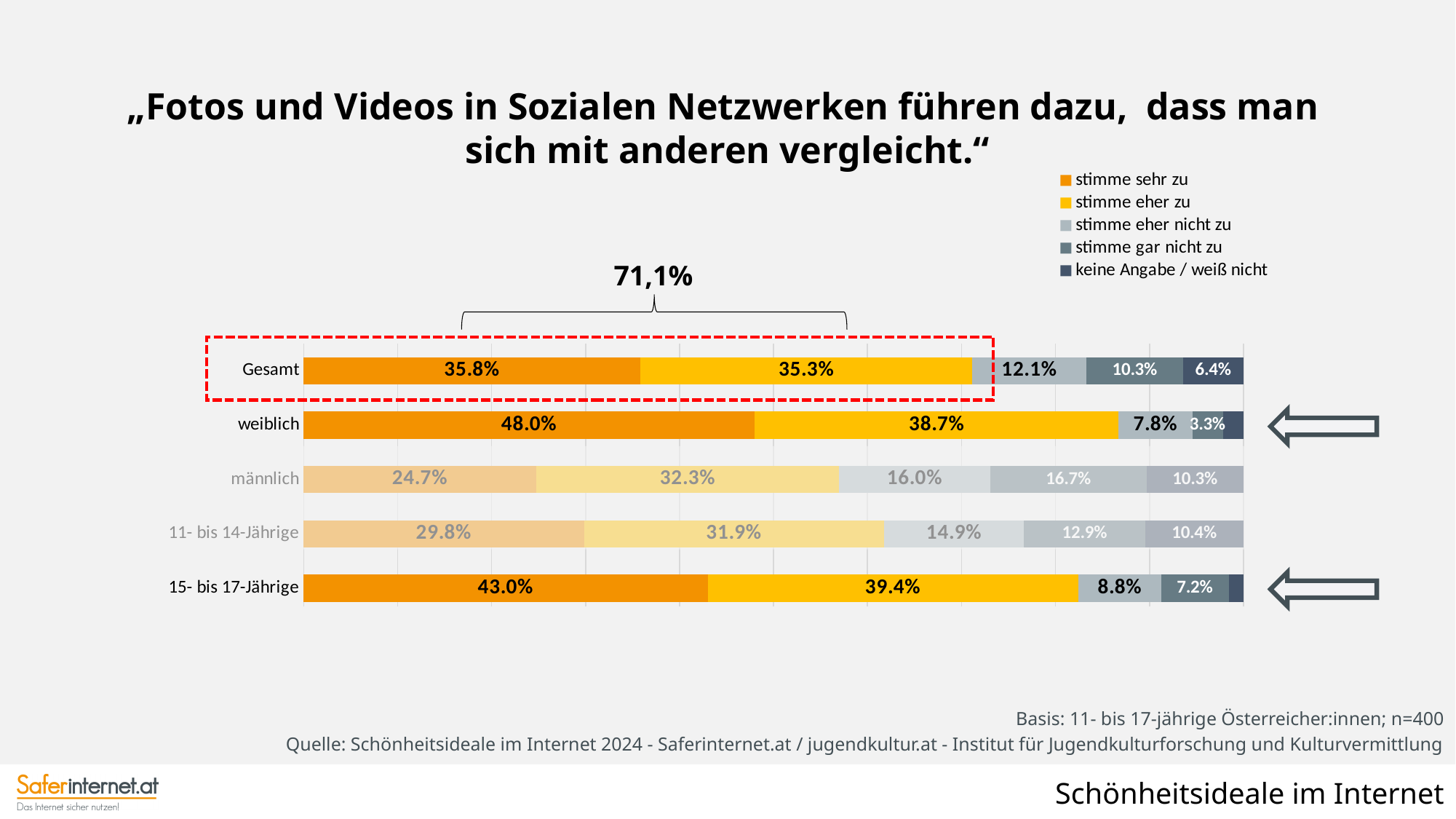
What is the difference between the "stimme sehr zu" values for weiblich and männlich? 23.3% What combined percentage is shown above the bracket over the Gesamt row's agreement segments? 71,1% What is the value of "keine Angabe / weiß nicht" for 11- bis 14-Jährige? 10.4% What type of chart is shown on the slide? stacked bar chart Which category has the highest value for "stimme sehr zu"? weiblich What is the value of "stimme sehr zu" for the Gesamt row? 35.8% How many series does the legend list? 5 How many categories (rows) are plotted in the chart? 5 What is the value of "stimme eher zu" for weiblich? 38.7% What is the value of "stimme gar nicht zu" for männlich? 16.7% Which is larger: the "stimme eher nicht zu" value for 15- bis 17-Jährige or for 11- bis 14-Jährige? 11- bis 14-Jährige Which category has the lowest value for "stimme sehr zu"? männlich